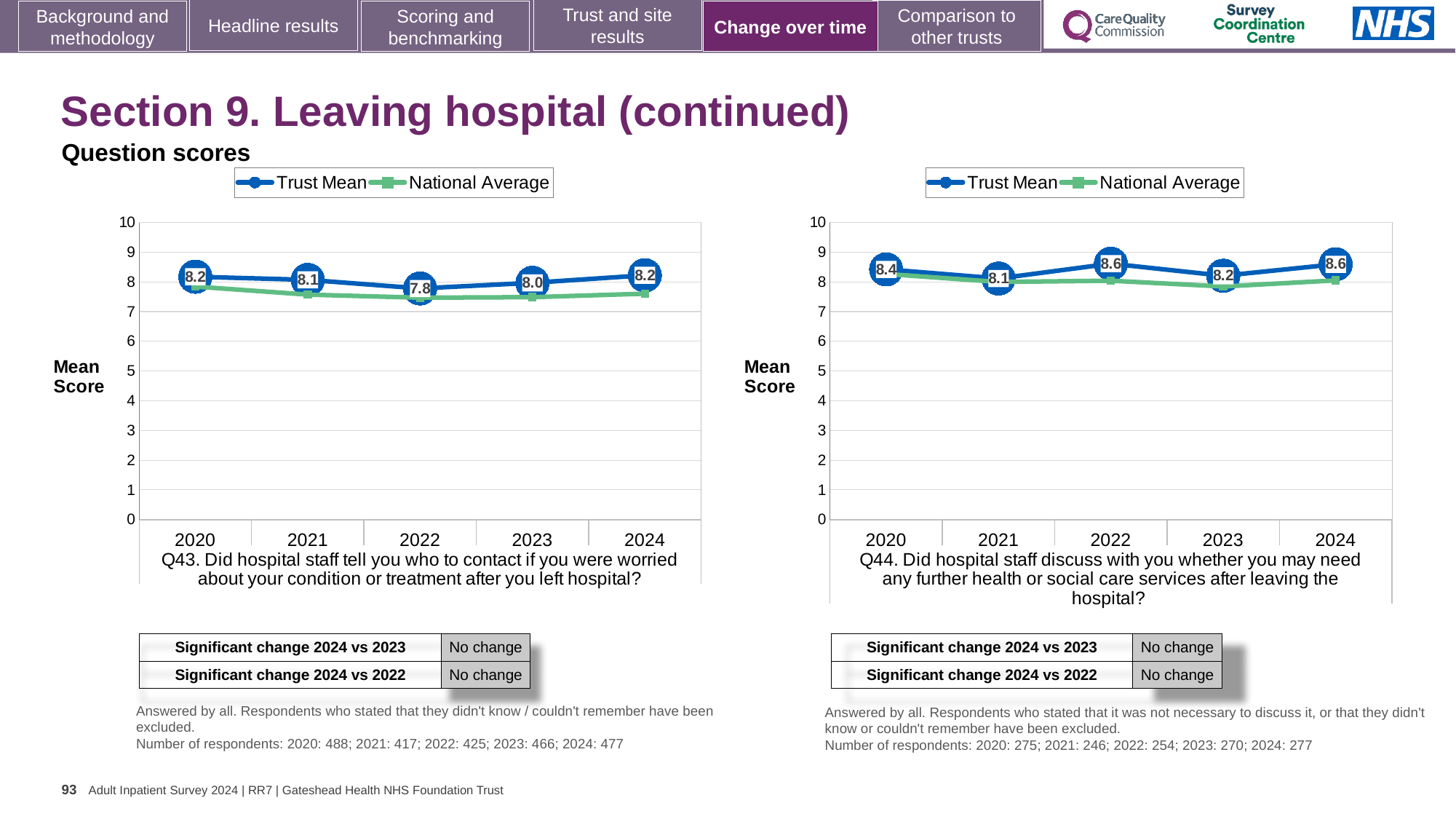
On the Q44 chart (right), what is the difference between the Trust Mean scores for 2022 and 2021? 0.5 How many years are plotted on the Q44 chart (right)? 5 What type of chart is the Q43 chart (left)? Line chart On the Q44 chart (right), which year has the lowest Trust Mean score? 2021 On the Q44 chart (right), is the Trust Mean score for 2023 larger or smaller than the Trust Mean score for 2022? smaller On the Q43 chart (left), what is the Trust Mean score for 2022? 7.8 On the Q44 chart (right), what is the Trust Mean score for 2020? 8.4 On the Q43 chart (left), what is the Trust Mean score for 2024? 8.2 On the Q43 chart (left), what is the difference between the Trust Mean scores for 2024 and 2022? 0.4 On the Q43 chart (left), is the National Average for 2022 greater or less than 8? less On the Q43 chart (left), which year has the lowest Trust Mean score? 2022 On the Q44 chart (right), what is the Trust Mean score for 2021? 8.1